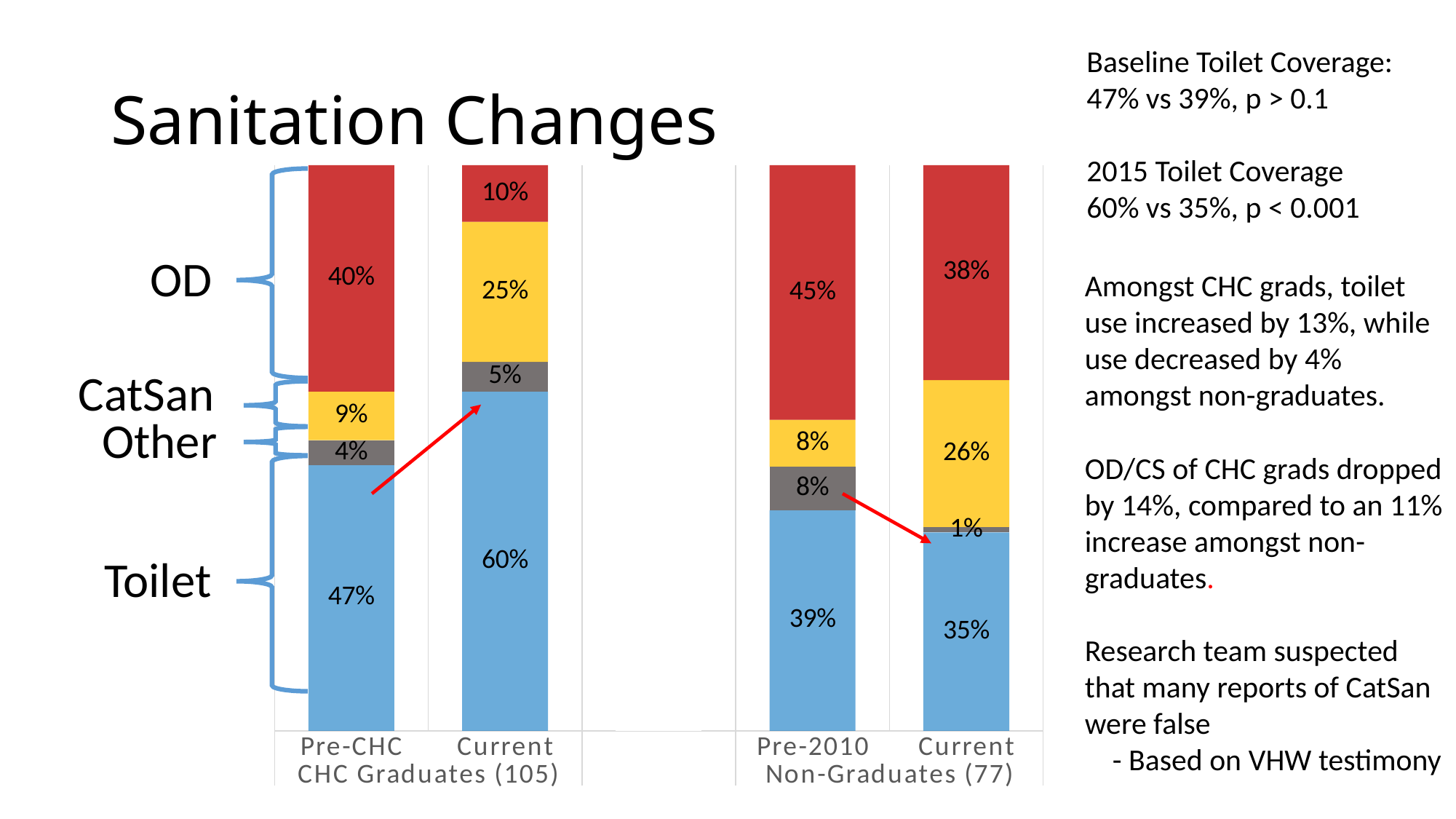
Which bar has the lowest OD share? Current (CHC Graduates) How many bars are shown in the chart? 4 What is the Other share for the Pre-2010 bar among Non-Graduates? 8% What is the OD share for the Current bar among CHC Graduates? 10% Which colour represents the Toilet category in the chart? Blue What type of chart is shown on the slide? Stacked bar chart What is the Toilet share for the Pre-CHC bar among CHC Graduates? 47% What is the CatSan share for the Current bar among Non-Graduates? 26% What is the difference in Toilet share between the Current and Pre-CHC bars for CHC Graduates? 13% Which bar has the highest Toilet share? Current (CHC Graduates) Which is larger: the OD share for Pre-2010 Non-Graduates or the OD share for Pre-CHC CHC Graduates? Pre-2010 Non-Graduates How many sanitation categories are stacked in each bar? 4